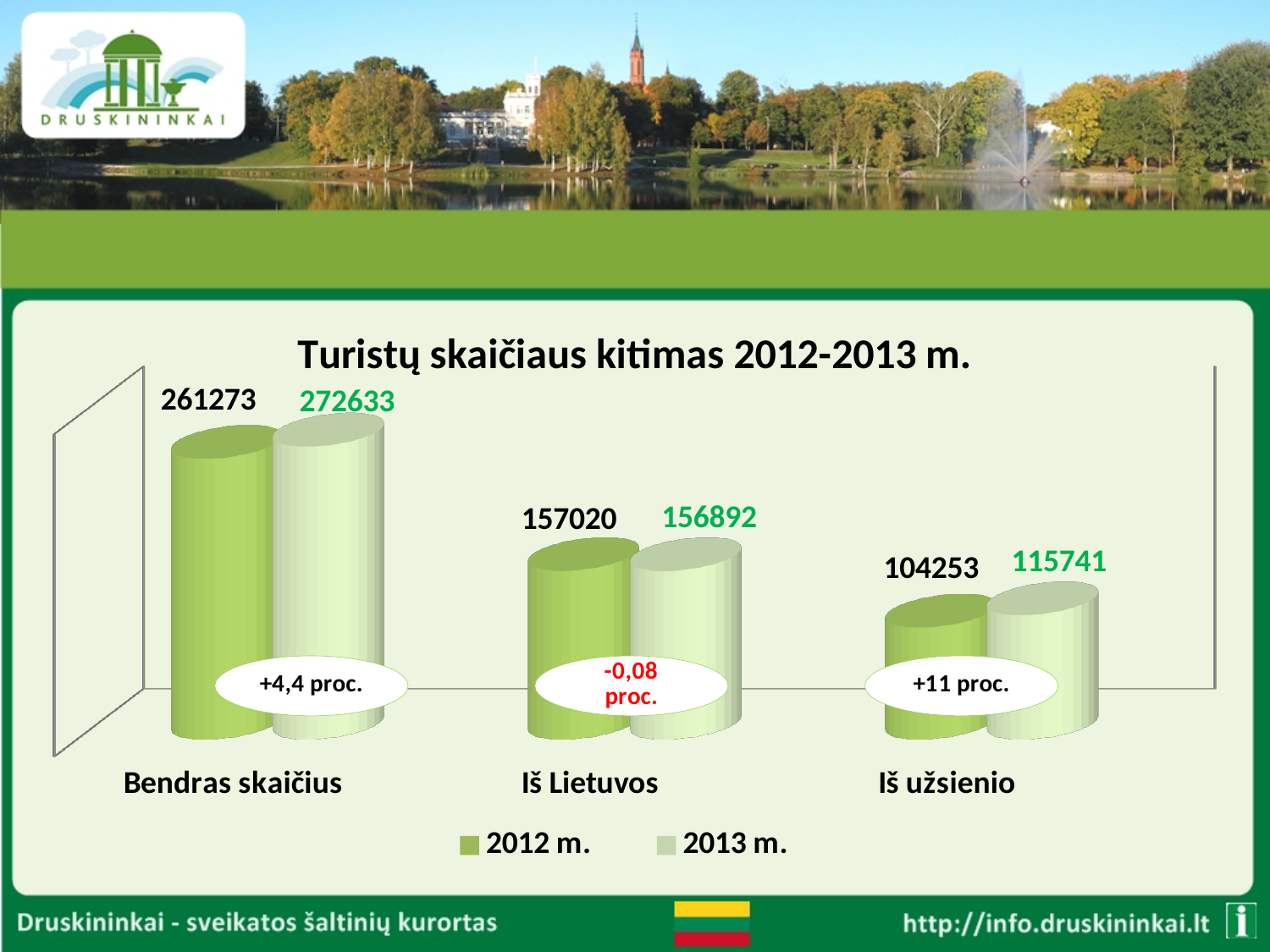
What is the value for 'Bendras skaičius' in the 2012 m. series? 261273 What is the value for 'Iš Lietuvos' in the 2013 m. series? 156892 What is the difference between the 2013 m. and 2012 m. values for 'Bendras skaičius'? 11360 What kind of chart is shown on the slide? Bar chart Which category has the lowest value in the 2012 m. series? Iš užsienio How many categories are shown on the x axis? 3 Which category has the highest value in the 2013 m. series? Bendras skaičius What is the difference between the 2013 m. and 2012 m. values for 'Iš užsienio'? 11488 What percentage change is shown for 'Iš Lietuvos'? -0,08 proc. What is the value for 'Iš užsienio' in the 2013 m. series? 115741 Which is larger for 'Iš Lietuvos': the 2012 m. value or the 2013 m. value? 2012 m. How many series does the legend list? 2